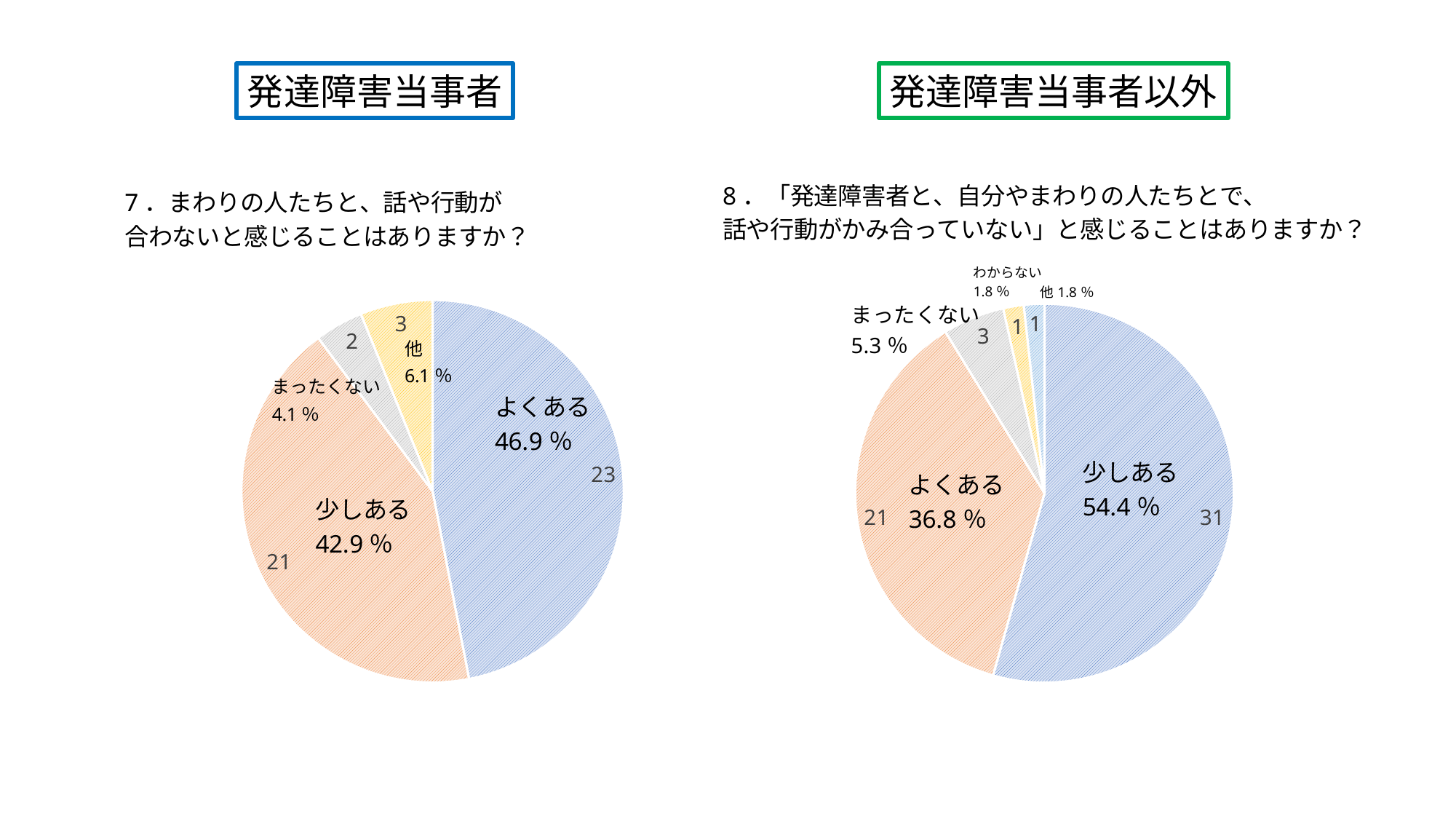
In the right pie chart (発達障害当事者以外), what count is shown for よくある? 21 In the right pie chart (発達障害当事者以外), how many slices are there? 5 In the right pie chart (発達障害当事者以外), which is larger, まったくない or わからない? まったくない In the right pie chart (発達障害当事者以外), which category has the largest share? 少しある In the left pie chart (発達障害当事者), which category has the smallest share? まったくない In the left pie chart (発達障害当事者), which category has the largest share? よくある In the right pie chart (発達障害当事者以外), what percentage is shown for 少しある? 54.4 % In the left pie chart (発達障害当事者), what percentage is shown for よくある? 46.9 % In the left pie chart (発達障害当事者), what is the difference in count between よくある and 少しある? 2 In the left pie chart (発達障害当事者), how many slices are there? 4 In the left pie chart (発達障害当事者), what count is shown for 少しある? 21 What kind of chart is shown on the left side of the slide (発達障害当事者)? pie chart